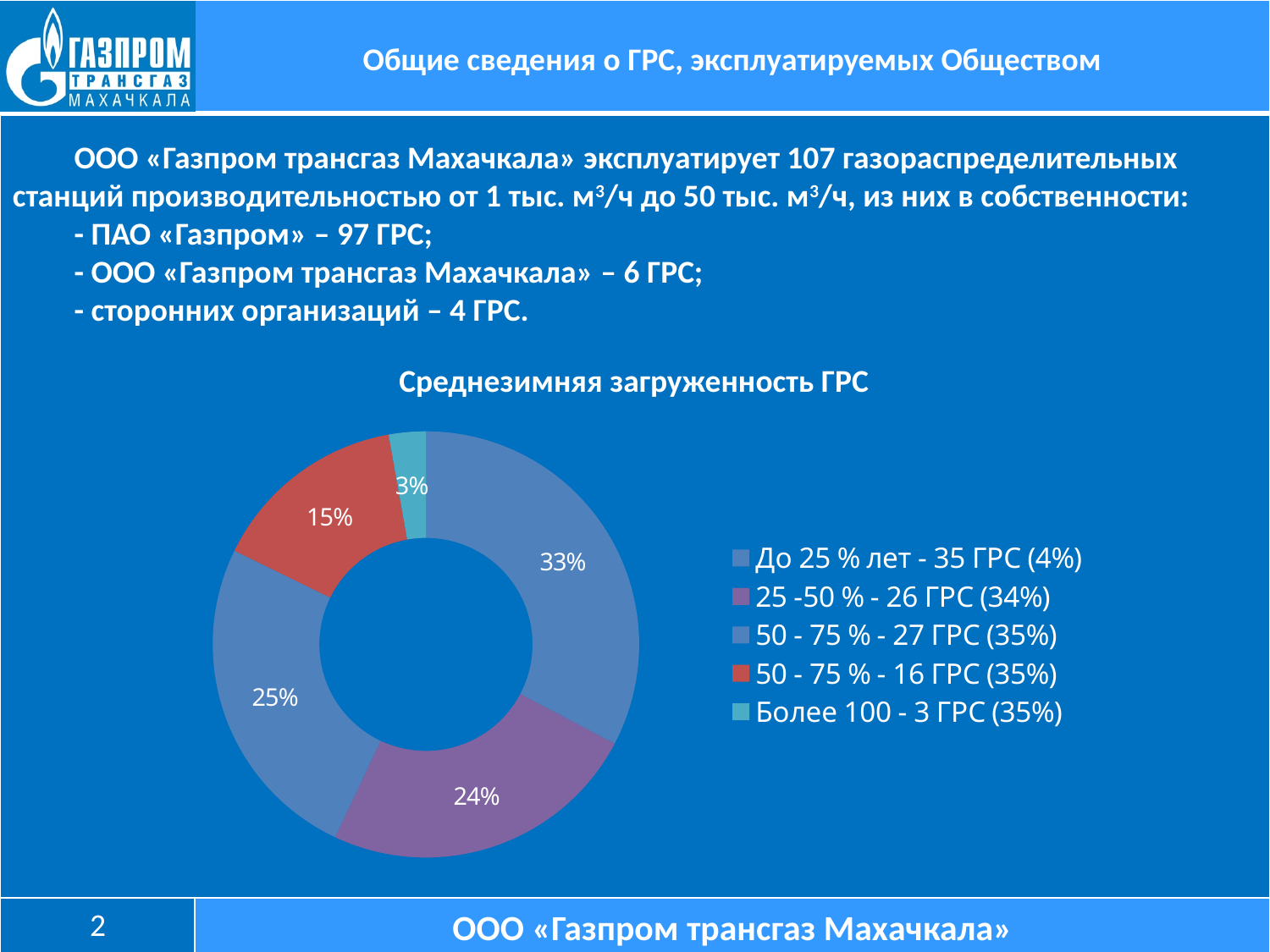
What percentage is shown on the slice for 'До 25 % лет - 35 ГРС'? 33% How many entries does the chart legend list? 5 What percentage is shown on the slice for '25 -50 % - 26 ГРС'? 24% How many slices does the doughnut chart have? 5 What is the difference between the 33% slice and the 15% slice? 18% What percentage is shown on the red slice (50 - 75 % - 16 ГРС)? 15% What percentage is shown on the slice for 'Более 100 - 3 ГРС'? 3% Which slice has the smallest share of the doughnut chart? Более 100 - 3 ГРС What is the title of the chart? Среднезимняя загруженность ГРС Which is larger: the slice for '25 -50 % - 26 ГРС' or the slice for '50 - 75 % - 27 ГРС'? 50 - 75 % - 27 ГРС What type of chart is shown on the slide? doughnut (pie) chart Which slice has the largest share of the doughnut chart? До 25 % лет - 35 ГРС